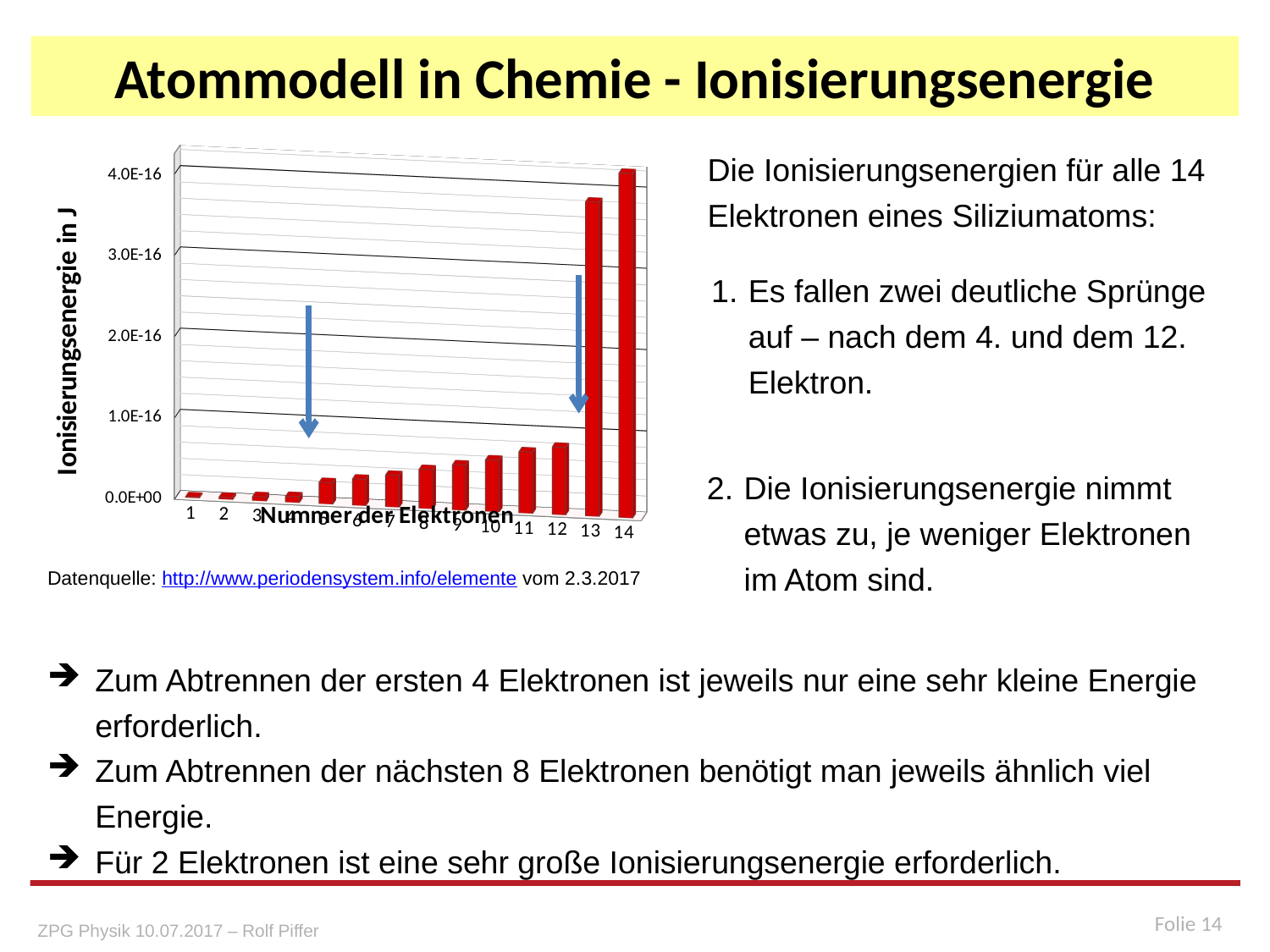
What kind of chart is shown on the slide? bar chart Is the value for electron number 12 greater or less than 1.0E-16? less Is the value for electron number 14 greater or less than 3.0E-16? greater What is the title of the horizontal axis of the chart? Nummer der Elektronen Which electron number has the highest ionisation energy in the chart? 14 Is the value for electron number 13 greater or less than 3.0E-16? greater What is the title of the vertical axis of the chart? Ionisierungsenergie in J How many bars (electron numbers) are plotted in the chart? 14 Which has the larger ionisation energy, electron number 13 or electron number 14? 14 Which has the larger ionisation energy, electron number 4 or electron number 12? 12 Do the values generally rise or fall as the electron number increases along the x axis? rise